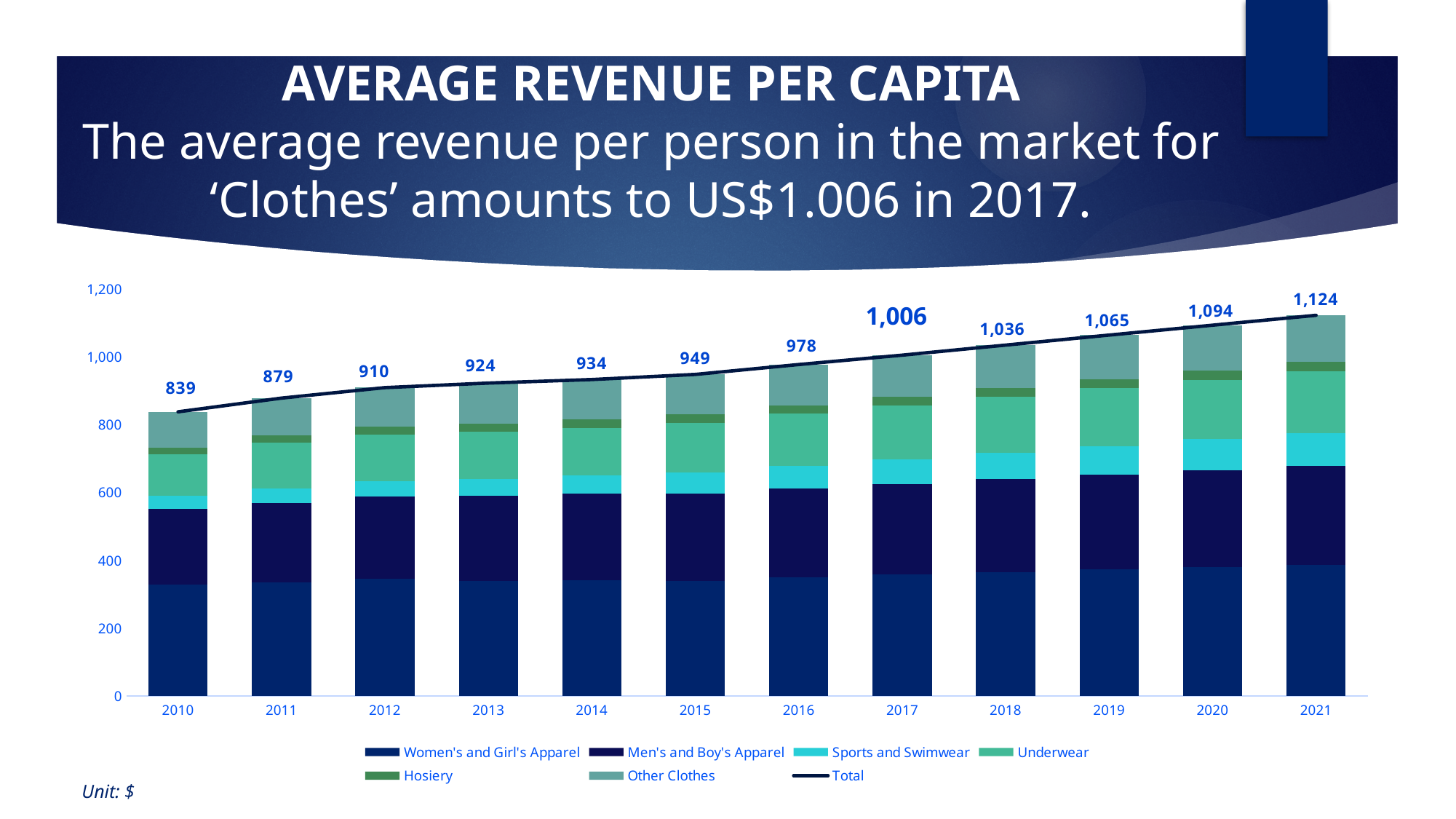
Which year has the highest total average revenue per capita? 2021 Is the Women's and Girl's Apparel value for 2010 greater or less than 400? less How many years are shown on the x axis? 12 What is the difference between the total for 2021 and the total for 2010? 285 What is the total value labelled for 2021? 1,124 What is the difference between the total for 2018 and the total for 2017? 30 Which year has a larger total, 2015 or 2016? 2016 Which year has the lowest total average revenue per capita? 2010 How many series does the legend list? 7 What is the total value labelled for 2010? 839 What is the total average revenue per capita shown for 2017? 1,006 Do the total values rise or fall from 2010 to 2021? rise